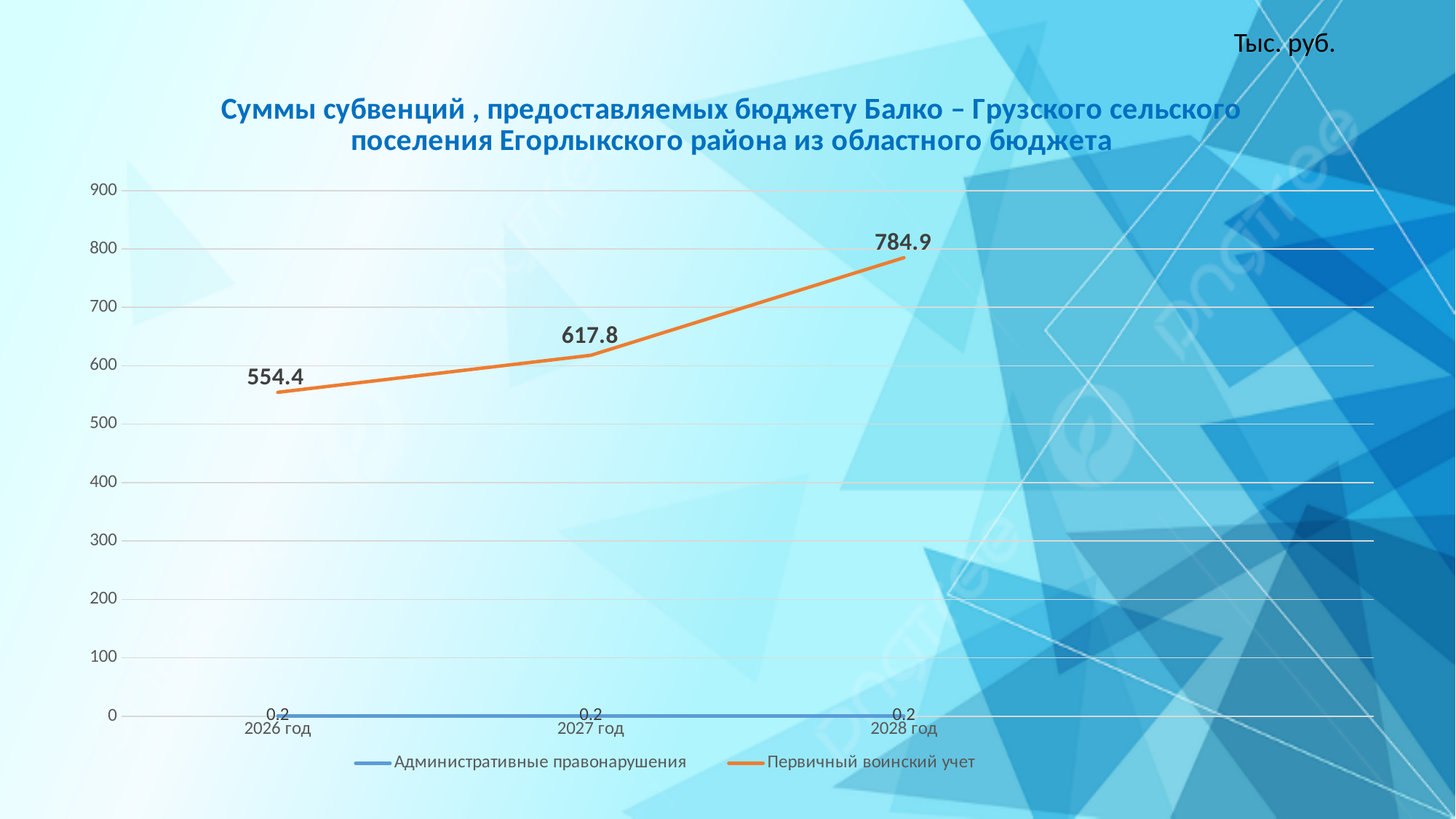
Does the value for Первичный воинский учет rise or fall from 2026 год to 2028 год? Rise In which year is the value for Первичный воинский учет lowest? 2026 год What is the value for Административные правонарушения in 2027 год? 0.2 What is the difference between the Первичный воинский учет values for 2028 год and 2026 год? 230.5 How many years are shown on the x axis? 3 What is the value for Первичный воинский учет in 2026 год? 554.4 What kind of chart is shown on the slide? Line chart What is the value for Первичный воинский учет in 2027 год? 617.8 How many series does the legend list? 2 What is the value for Первичный воинский учет in 2028 год? 784.9 In which year is the value for Первичный воинский учет highest? 2028 год Which series has the larger value in 2028 год, Административные правонарушения or Первичный воинский учет? Первичный воинский учет